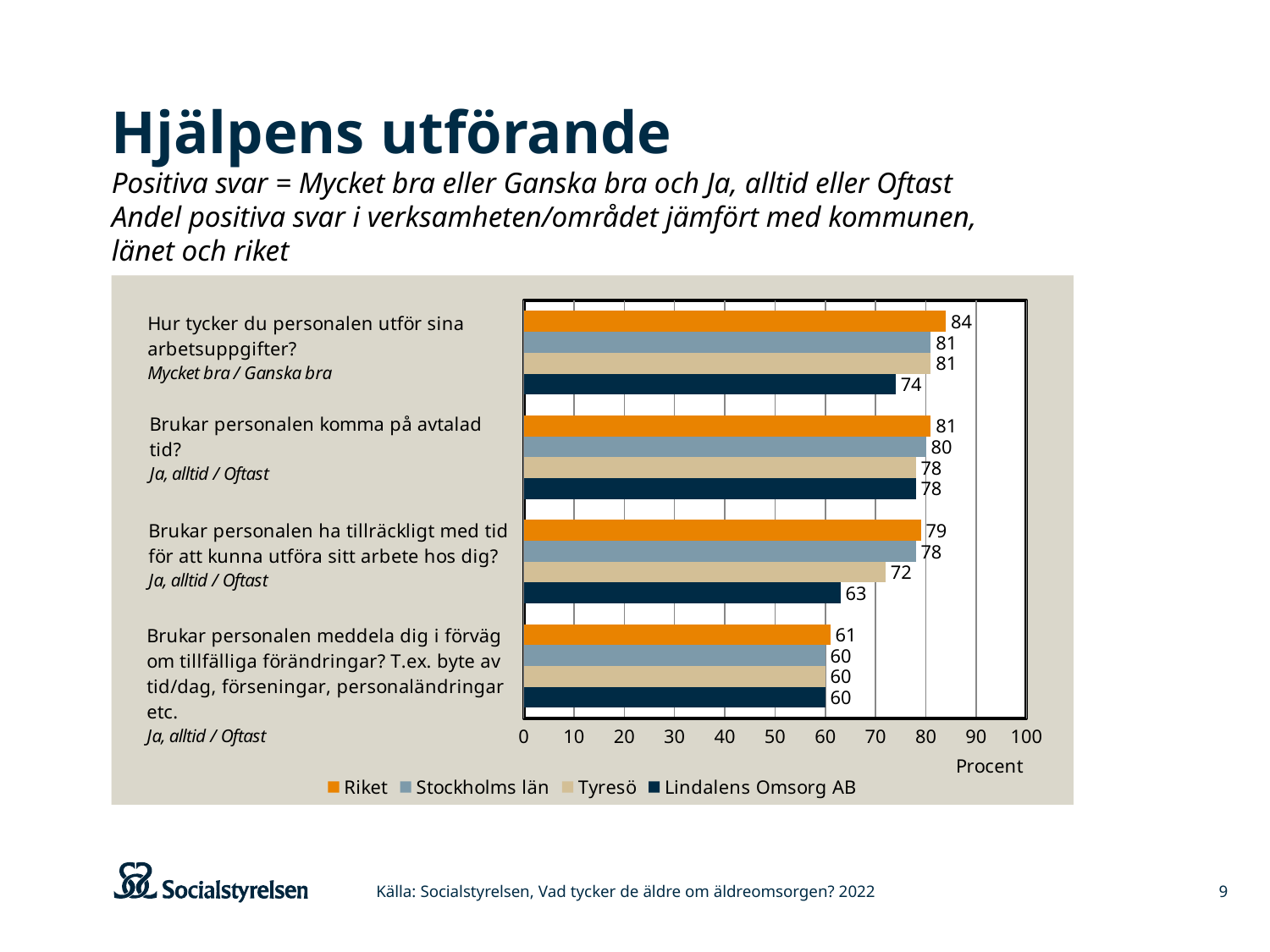
Which series has the lowest value on the question "Hur tycker du personalen utför sina arbetsuppgifter?"? Lindalens Omsorg AB What is the value for Riket on the question "Hur tycker du personalen utför sina arbetsuppgifter?"? 84 What is the difference between Tyresö and Lindalens Omsorg AB on the question "Brukar personalen ha tillräckligt med tid för att kunna utföra sitt arbete hos dig?"? 9 How many question categories are shown on the chart? 4 Which series has the highest value on the question "Brukar personalen ha tillräckligt med tid för att kunna utföra sitt arbete hos dig?"? Riket What is the difference between Riket and Lindalens Omsorg AB on the question "Hur tycker du personalen utför sina arbetsuppgifter?"? 10 What kind of chart is shown on the slide? Bar chart What is the value for Lindalens Omsorg AB on the question "Brukar personalen ha tillräckligt med tid för att kunna utföra sitt arbete hos dig?"? 63 What is the value for Stockholms län on the question "Brukar personalen meddela dig i förväg om tillfälliga förändringar?"? 60 On the question "Brukar personalen komma på avtalad tid?", which is larger: Riket or Tyresö? Riket What is the value for Tyresö on the question "Brukar personalen komma på avtalad tid?"? 78 How many series does the legend list? 4